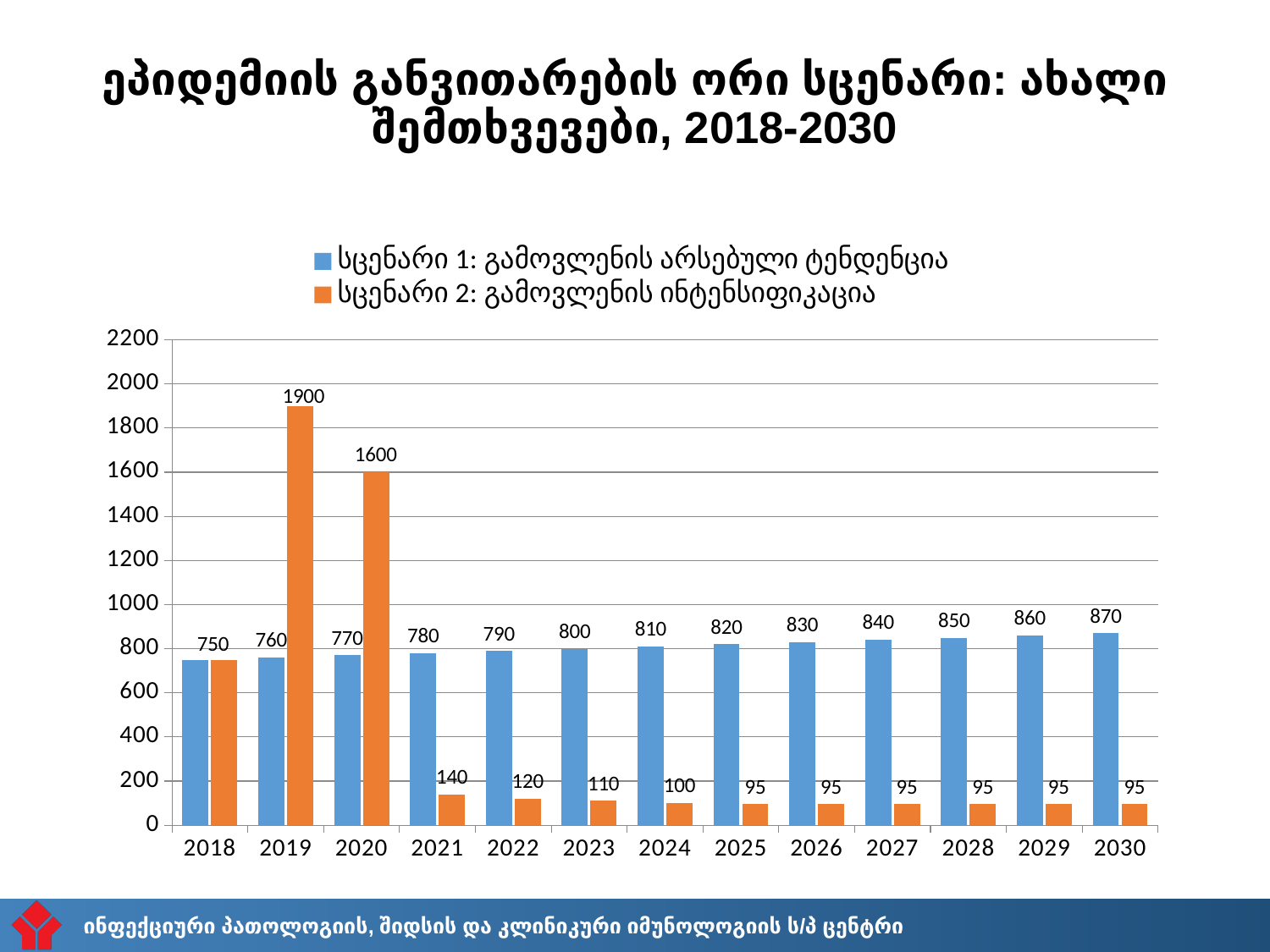
Do the values for სცენარი 1 (Scenario 1) rise or fall from 2018 to 2030? rise In which year is the value for სცენარი 2 (Scenario 2) highest? 2019 What is the value for სცენარი 2 (Scenario 2) in 2021? 140 What is the value for სცენარი 1 (Scenario 1) in 2030? 870 Which is larger in 2022: the value for სცენარი 1 (Scenario 1) or სცენარი 2 (Scenario 2)? სცენარი 1 (Scenario 1) Which colour represents სცენარი 2 (Scenario 2) in the legend? orange In which year is the value for სცენარი 1 (Scenario 1) lowest? 2018 What type of chart is shown on the slide? bar chart How many years are shown on the x axis? 13 How many series does the legend list? 2 What is the value for სცენარი 2 (Scenario 2) in 2019? 1900 What is the difference between the სცენარი 2 (Scenario 2) values for 2019 and 2020? 300